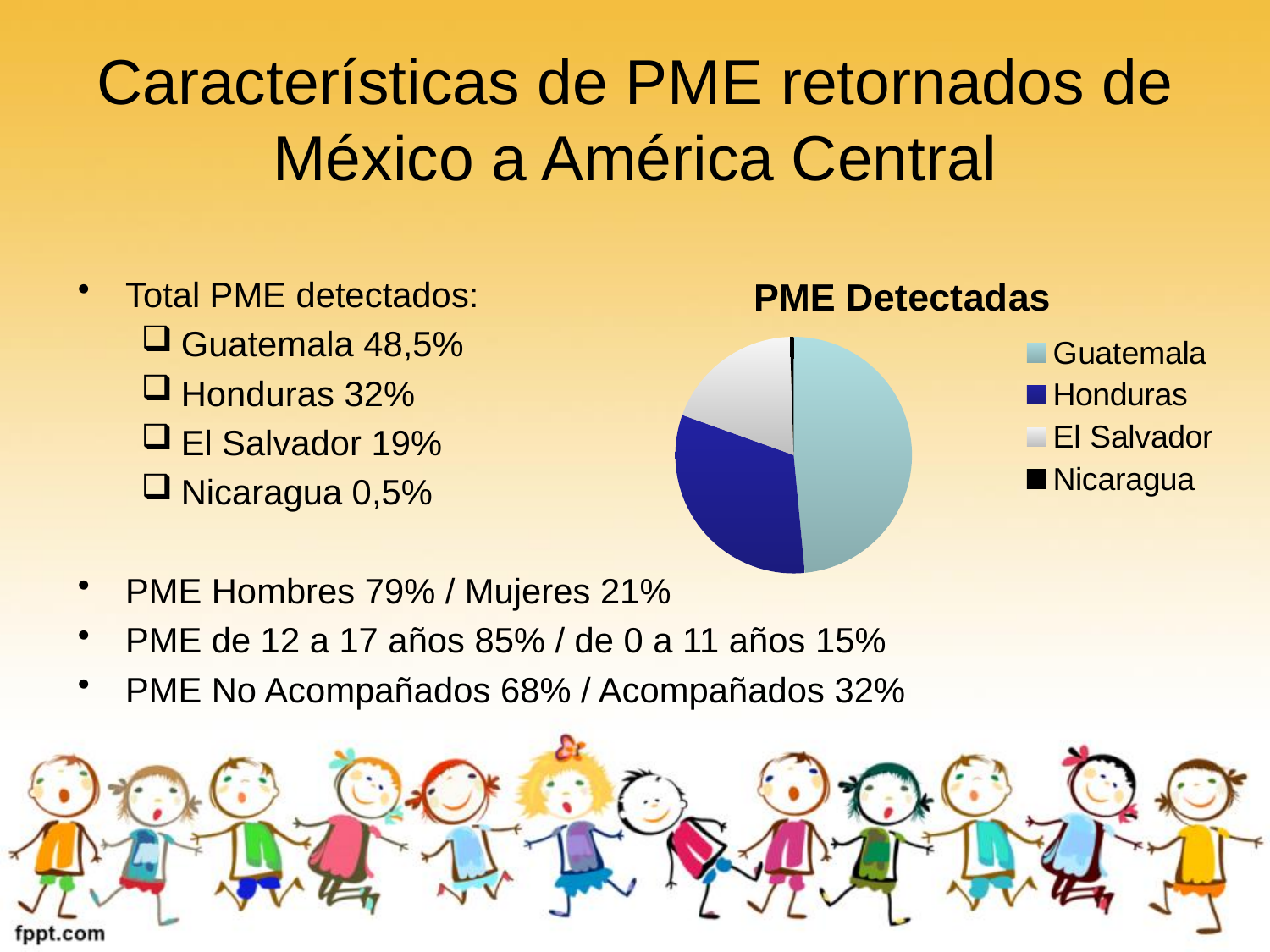
Which colour represents Honduras in the pie chart? dark blue What share of the pie chart does Guatemala represent? 48,5% Which category has the smallest slice of the pie chart? Nicaragua Which slice is larger in the pie chart, Honduras or El Salvador? Honduras How many categories does the legend of the pie chart list? 4 What is the title of the chart? PME Detectadas Which category has the largest slice of the pie chart? Guatemala What share of the pie chart does Nicaragua represent? 0,5% What share of the pie chart does El Salvador represent? 19% What kind of chart is shown on the slide? pie chart What is the difference in percentage points between the Honduras and El Salvador slices? 13